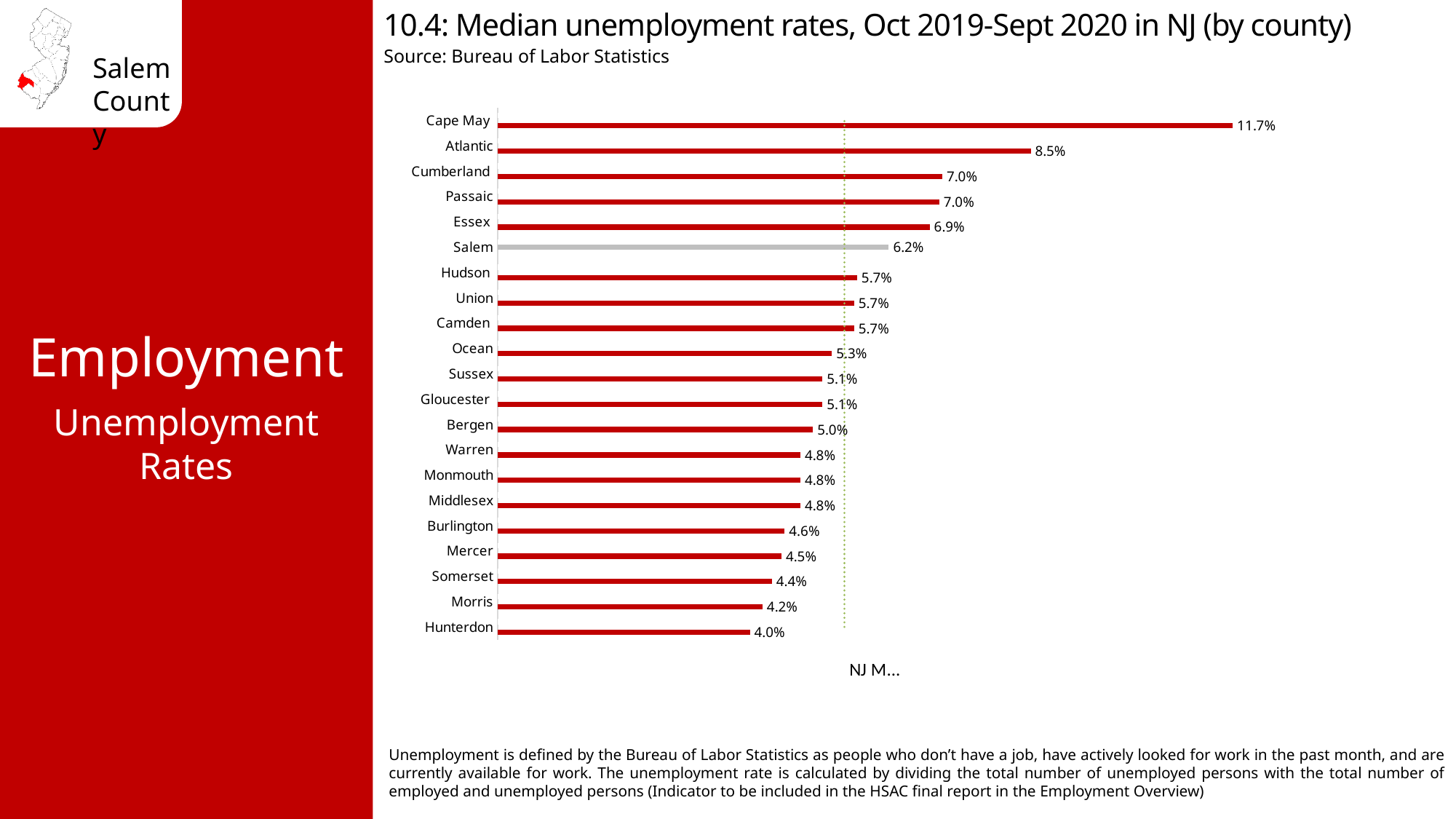
Which county's bar is shown in grey instead of red? Salem Which county has a higher median unemployment rate, Essex or Salem? Essex What type of chart is used to show the median unemployment rates? Bar chart What is the median unemployment rate for Cape May? 11.7% What is the median unemployment rate for Salem County? 6.2% Which county has the highest median unemployment rate? Cape May How many counties are shown in the chart? 21 What is the difference between the median unemployment rates of Salem and Hunterdon? 2.2% What is the difference between the median unemployment rates of Cape May and Atlantic? 3.2% Which county has a higher median unemployment rate, Ocean or Bergen? Ocean Which county has the lowest median unemployment rate? Hunterdon What is the median unemployment rate for Hunterdon? 4.0%